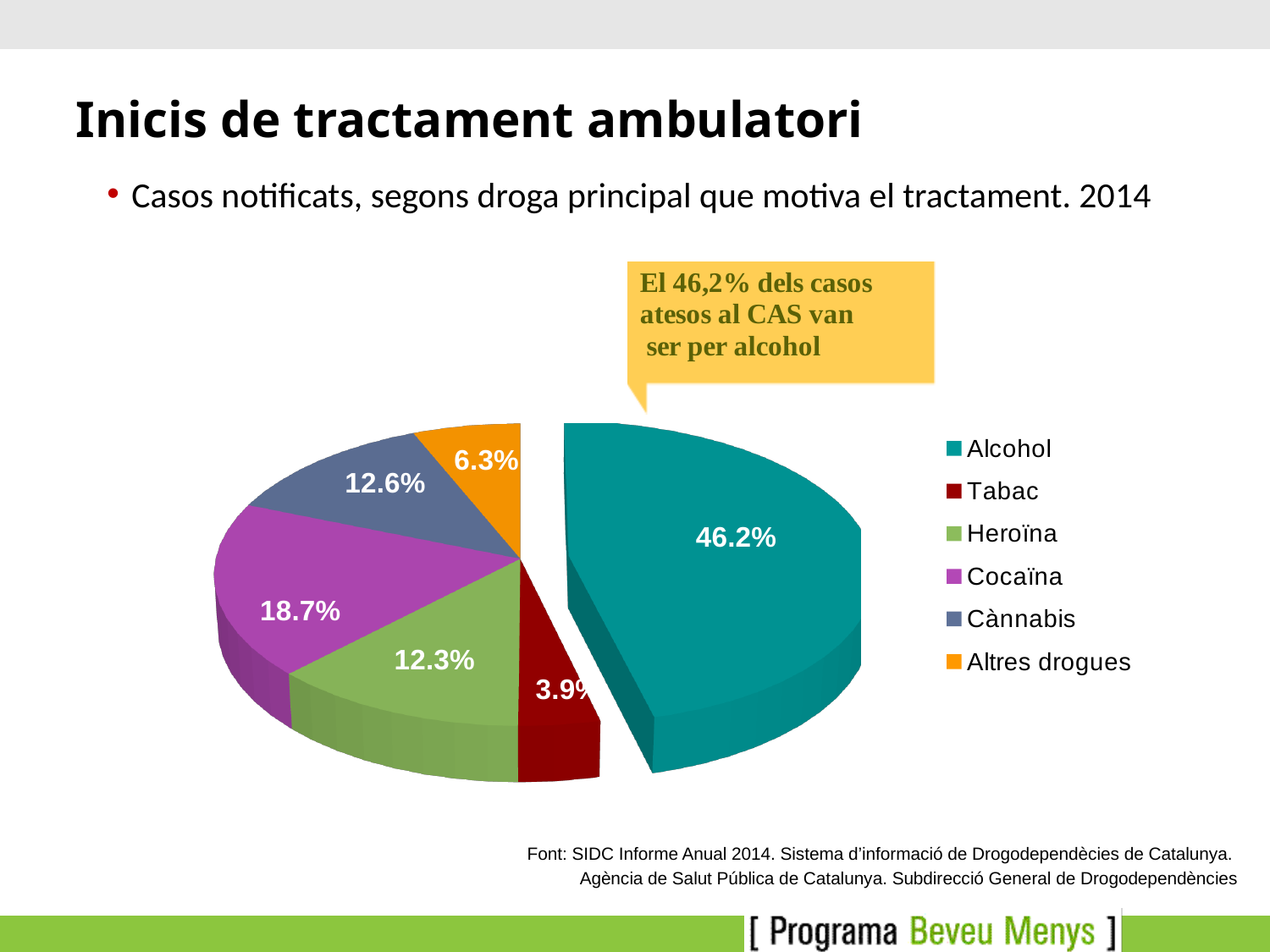
What is the difference in percentage points between Cocaïna and Altres drogues? 12.4 What percentage is shown for Tabac? 3.9% What percentage is shown for Altres drogues? 6.3% Which category is shown in orange in the legend? Altres drogues Which category has the largest slice of the pie? Alcohol Which category has the smallest slice of the pie? Tabac What share of the pie does Alcohol represent? 46.2% How many categories does the pie chart show? 6 Which is larger, the share for Cocaïna or the share for Heroïna? Cocaïna What is the difference in percentage points between Alcohol and Cocaïna? 27.5 What percentage is shown for Cocaïna? 18.7% What kind of chart is shown on the slide? Pie chart